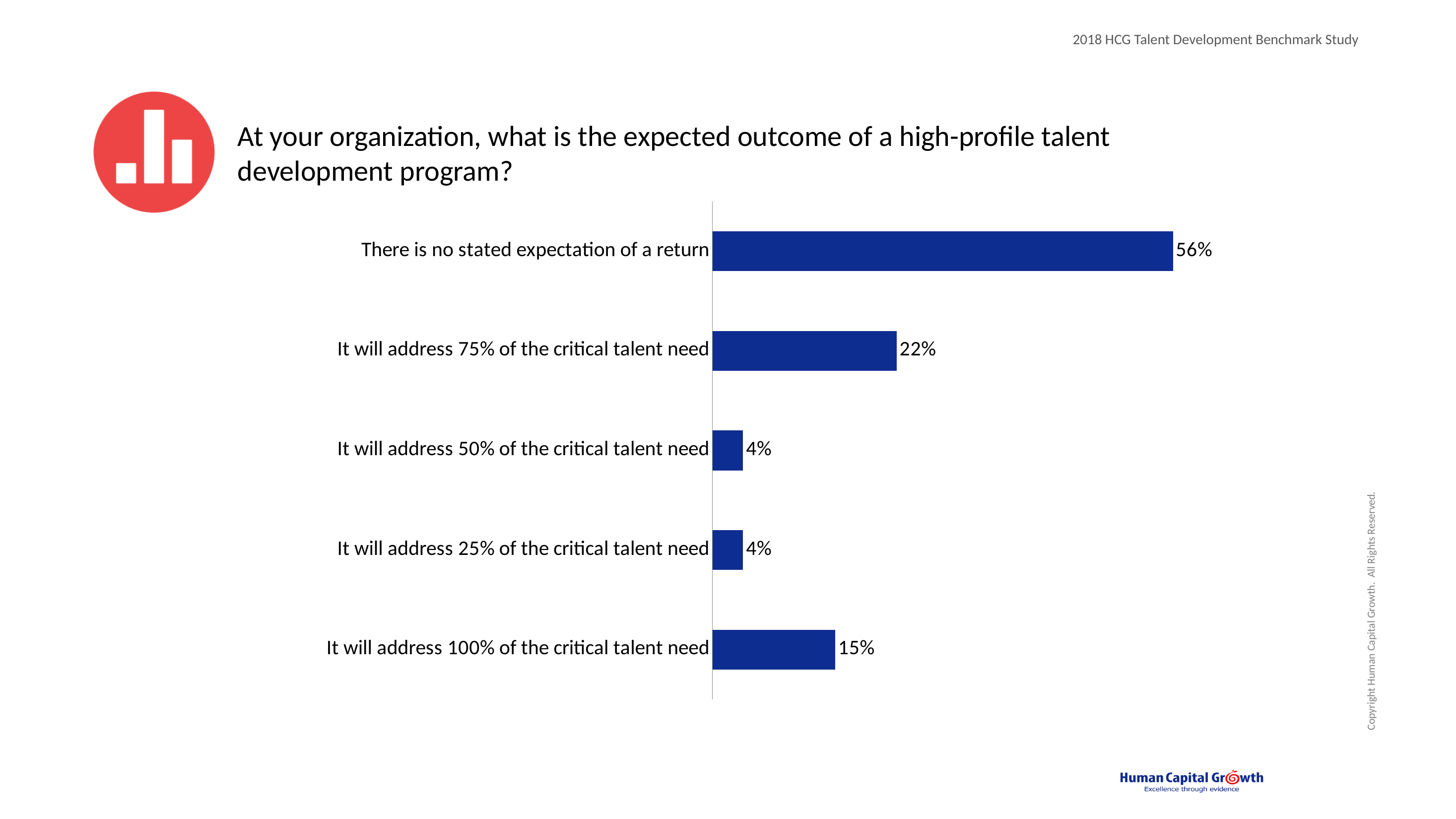
How many categories are shown in the chart? 5 What kind of chart is shown on the slide? Bar chart What is the difference between "It will address 75% of the critical talent need" and "It will address 100% of the critical talent need"? 7 percentage points Which category has the highest value? There is no stated expectation of a return What percentage of respondents said there is no stated expectation of a return? 56% What is the difference between "There is no stated expectation of a return" and "It will address 75% of the critical talent need"? 34 percentage points How many categories have a value of 4%? 2 Which is larger: the value for "It will address 100% of the critical talent need" or "It will address 25% of the critical talent need"? It will address 100% of the critical talent need What is the value for "It will address 50% of the critical talent need"? 4% What is the value for "It will address 100% of the critical talent need"? 15% What is the value for "It will address 75% of the critical talent need"? 22% What colour are the bars in the chart? Dark blue